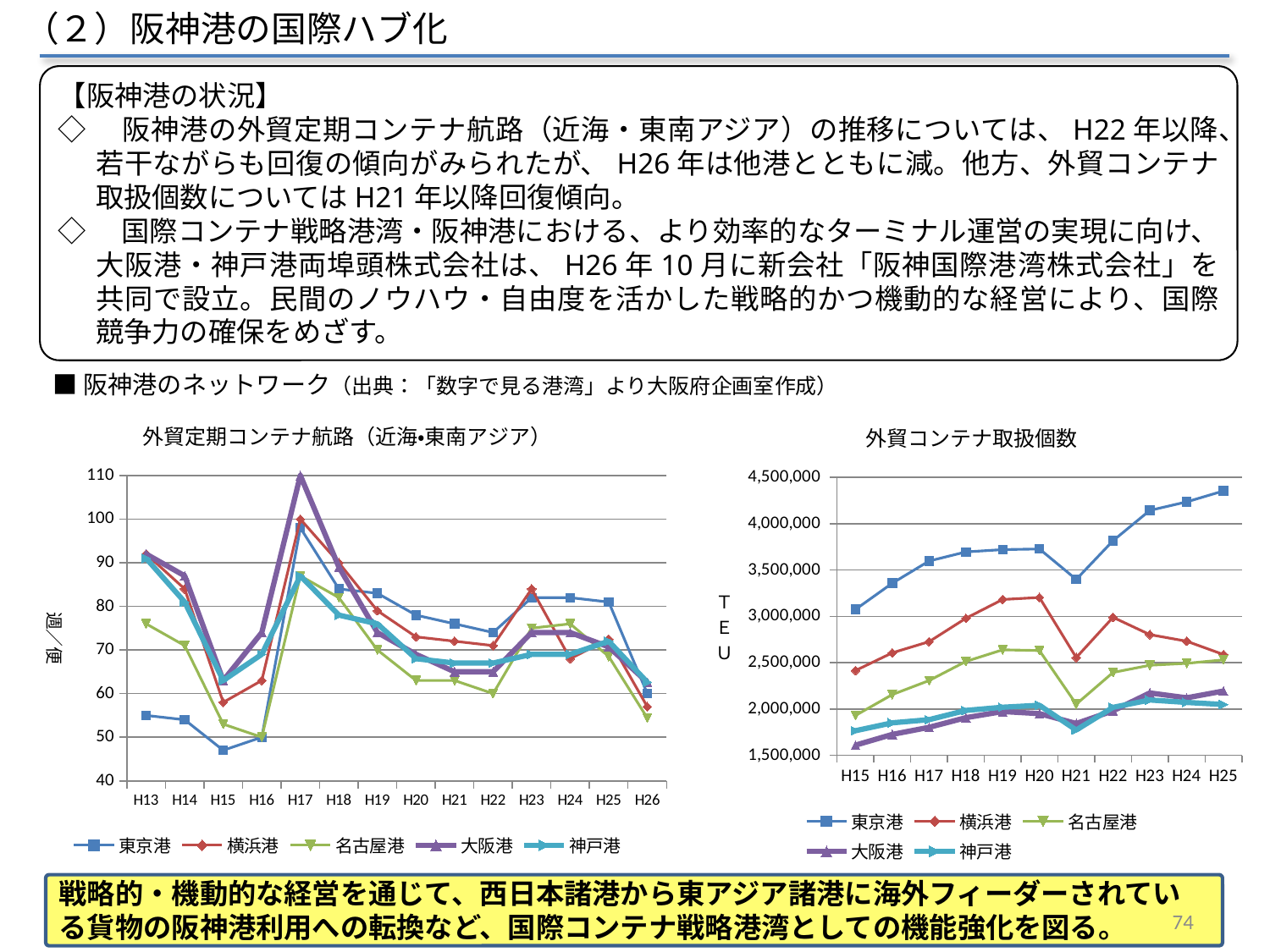
In the 外貿定期コンテナ航路（近海•東南アジア） chart on the left, which port has the lowest value at H15? 東京港 How many years are shown on the x axis of the 外貿コンテナ取扱個数 chart on the right? 11 In the 外貿定期コンテナ航路（近海•東南アジア） chart on the left, which is higher at H15, 東京港 or 横浜港? 横浜港 How many series does the legend of the 外貿コンテナ取扱個数 chart on the right list? 5 How many years are shown on the x axis of the 外貿定期コンテナ航路（近海•東南アジア） chart on the left? 14 In the 外貿定期コンテナ航路（近海•東南アジア） chart on the left, is the value for 大阪港 at H17 greater or less than 100? greater In the 外貿コンテナ取扱個数 chart on the right, is the value for 東京港 at H25 greater or less than 4,000,000? greater In the 外貿コンテナ取扱個数 chart on the right, which port has the highest value at H25? 東京港 In the 外貿コンテナ取扱個数 chart on the right, is the value for 東京港 at H21 greater or less than 3,500,000? less What kind of chart is the 外貿定期コンテナ航路（近海•東南アジア） chart on the left? line chart In the 外貿コンテナ取扱個数 chart on the right, does the 東京港 line rise or fall from H21 to H25? rise